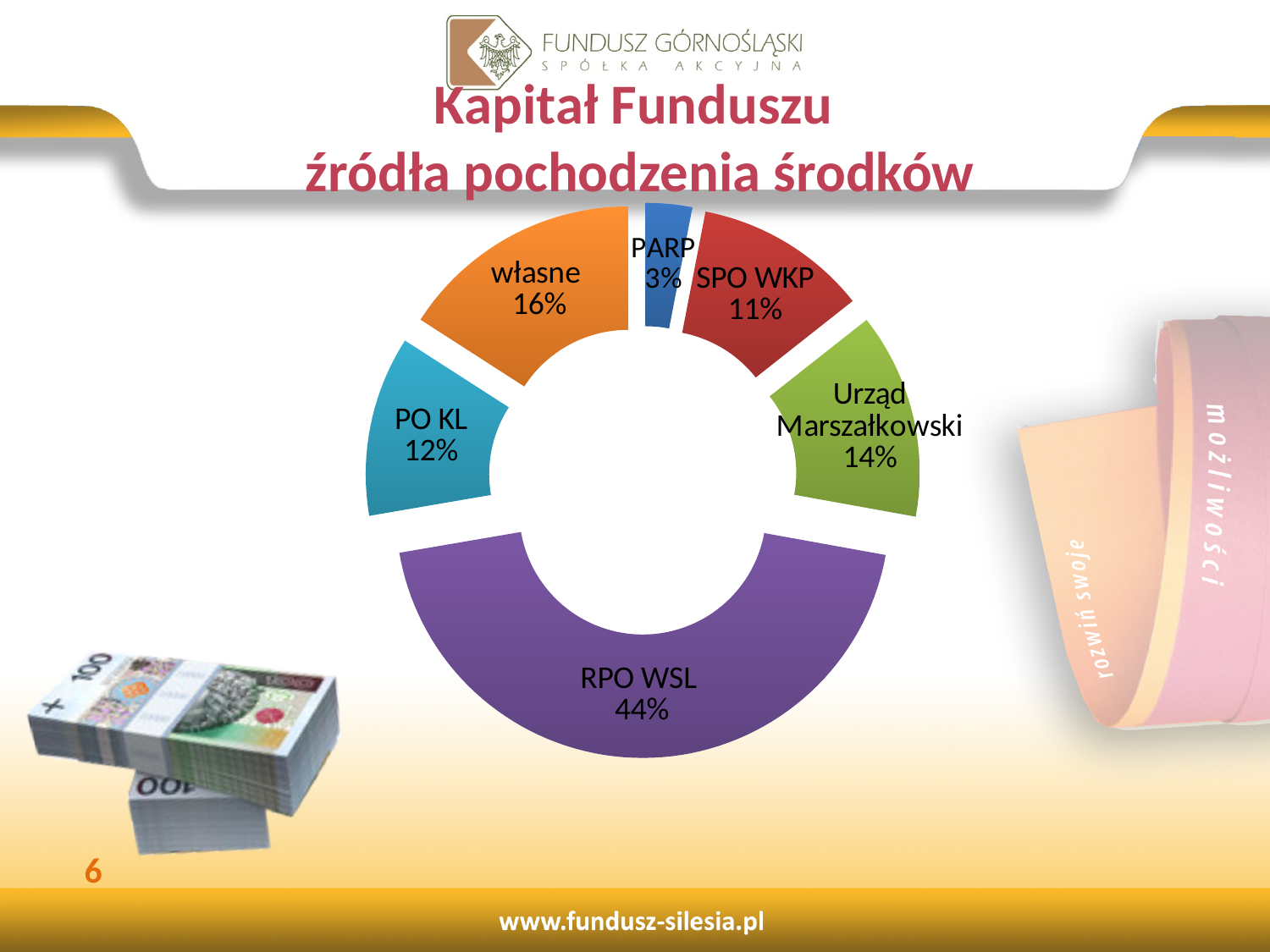
How many sources of funds are shown in the chart? 6 Which source has the largest share of the fund's capital? RPO WSL What colour is the RPO WSL segment? Purple What is the difference in percentage points between własne and PO KL? 4 What share of the fund's capital comes from RPO WSL? 44% Which is larger, the share for SPO WKP or the share for PO KL? PO KL What type of chart is shown on the slide? Doughnut chart What is the combined share of RPO WSL and PO KL? 56% What share is attributed to Urząd Marszałkowski? 14% Which source has the smallest share of the fund's capital? PARP What percentage is shown for PARP? 3% What percentage is shown for własne (own funds)? 16%